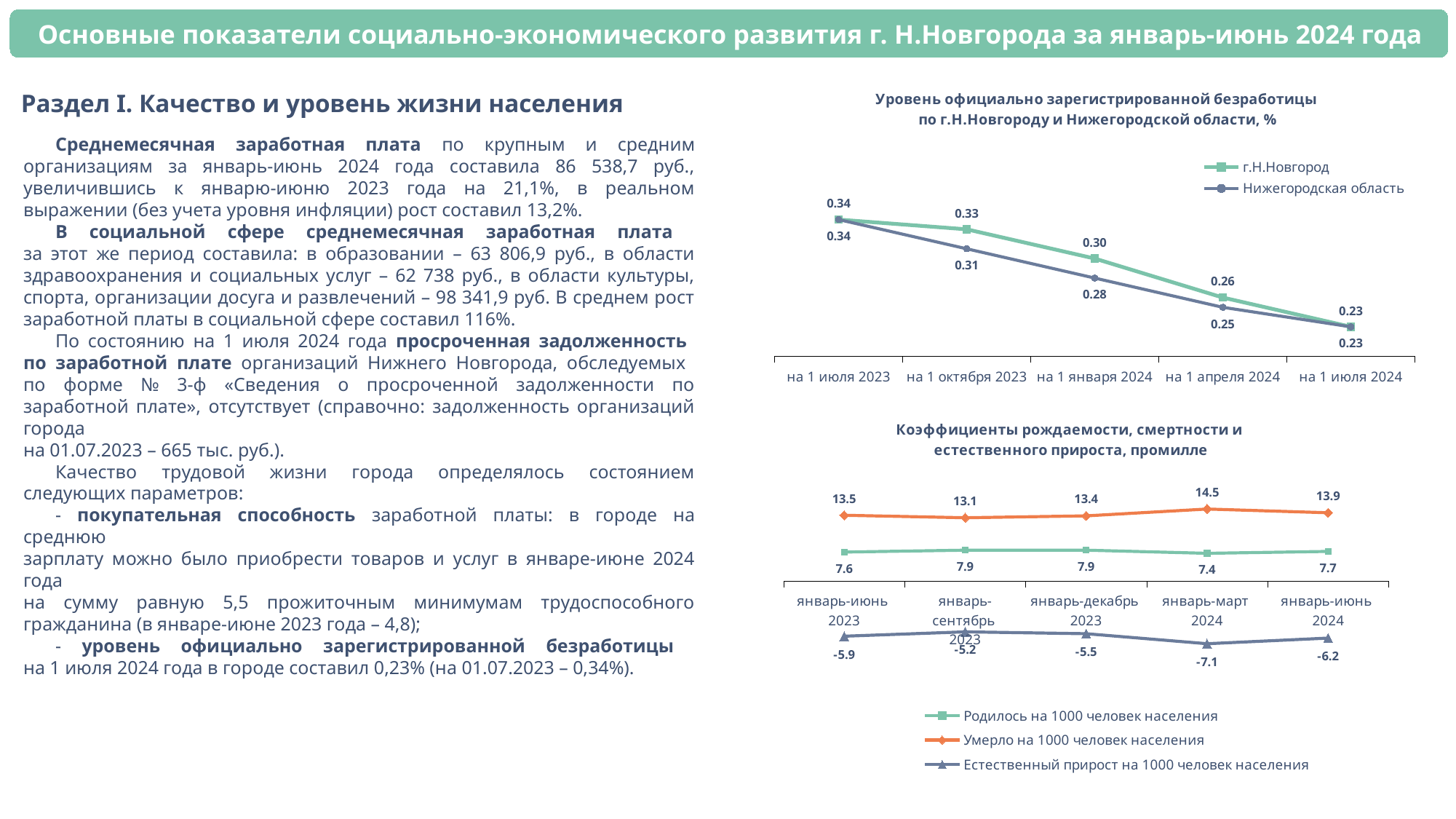
In the chart 'Уровень официально зарегистрированной безработицы по г.Н.Новгороду и Нижегородской области, %', does the г.Н.Новгород series rise or fall from 1 июля 2023 to 1 июля 2024? fall What type of chart is 'Коэффициенты рождаемости, смертности и естественного прироста, промилле'? line chart In the chart 'Коэффициенты рождаемости, смертности и естественного прироста, промилле', in which period is 'Умерло на 1000 человек населения' highest? январь-март 2024 In the chart 'Уровень официально зарегистрированной безработицы по г.Н.Новгороду и Нижегородской области, %', what is the difference between the г.Н.Новгород values on 1 июля 2023 and 1 июля 2024? 0.11 In the chart 'Коэффициенты рождаемости, смертности и естественного прироста, промилле', what is the value of 'Умерло на 1000 человек населения' for январь-март 2024? 14.5 In the chart 'Уровень официально зарегистрированной безработицы по г.Н.Новгороду и Нижегородской области, %', how many series does the legend list? 2 In the chart 'Уровень официально зарегистрированной безработицы по г.Н.Новгороду и Нижегородской области, %', how many dates are shown on the x axis? 5 In the chart 'Коэффициенты рождаемости, смертности и естественного прироста, промилле', what is the value of 'Естественный прирост на 1000 человек населения' for январь-июнь 2024? -6.2 In the chart 'Уровень официально зарегистрированной безработицы по г.Н.Новгороду и Нижегородской области, %', what is the value for г.Н.Новгород on 1 января 2024? 0.30 In the chart 'Уровень официально зарегистрированной безработицы по г.Н.Новгороду и Нижегородской области, %', what is the value for Нижегородская область on 1 апреля 2024? 0.25 In the chart 'Коэффициенты рождаемости, смертности и естественного прироста, промилле', in which period is 'Родилось на 1000 человек населения' lowest? январь-март 2024 In the chart 'Коэффициенты рождаемости, смертности и естественного прироста, промилле', what is the difference between 'Умерло' and 'Родилось' for январь-июнь 2023? 5.9